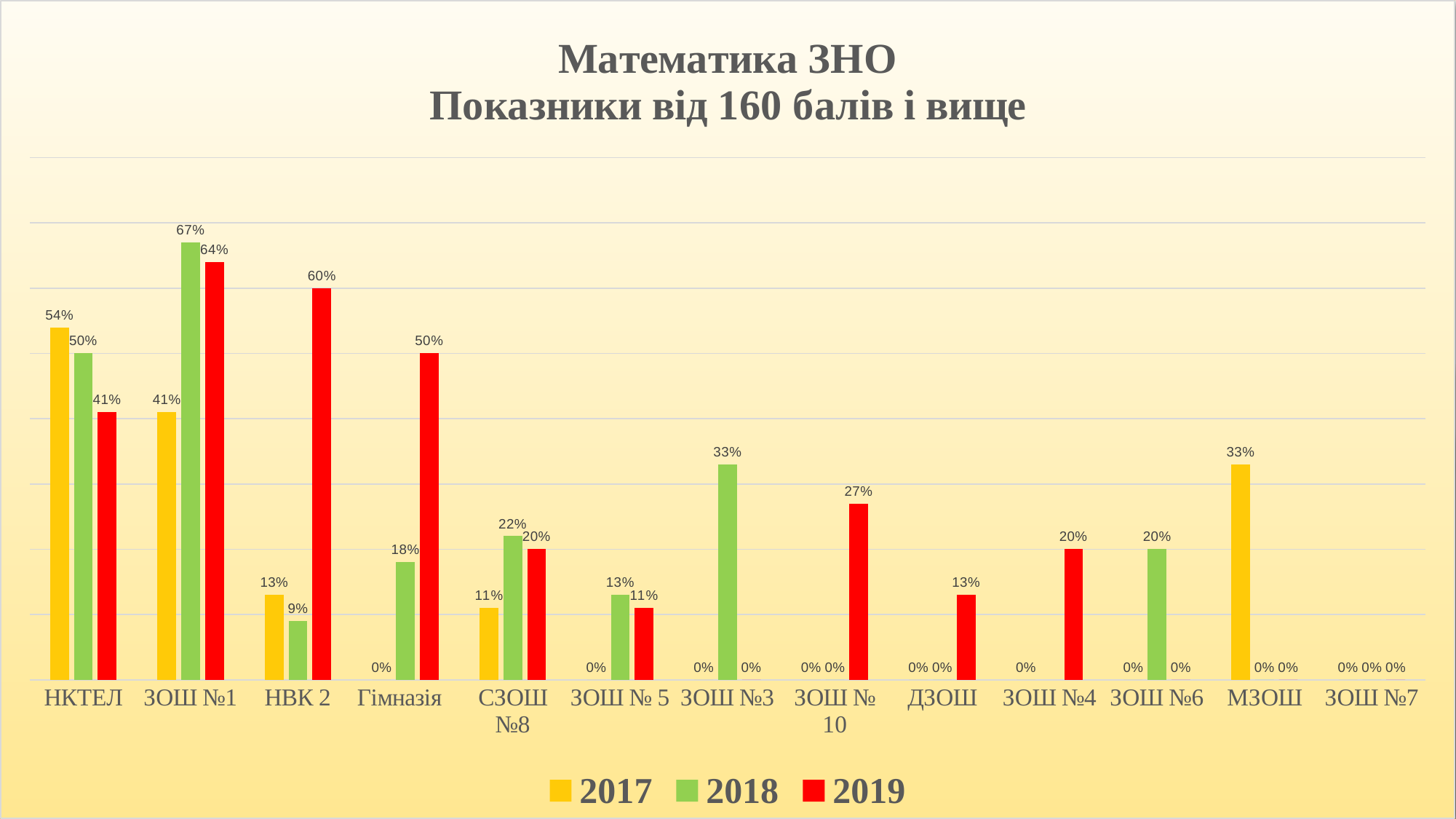
Which category has the highest 2017 value? НКТЕЛ What is the 2017 value for НКТЕЛ? 54% What is the difference between the 2017 and 2019 values for НКТЕЛ? 13% What is the 2019 value for НВК 2? 60% What is the 2018 value for ЗОШ №1? 67% What is the 2019 value for Гімназія? 50% Which is larger for СЗОШ №8: the 2018 value or the 2019 value? 2018 Which category has the highest 2019 value? ЗОШ №1 What kind of chart is shown on the slide? bar chart What is the difference between the 2018 and 2019 values for ЗОШ №1? 3% How many series does the legend list? 3 How many categories are shown on the x axis? 13